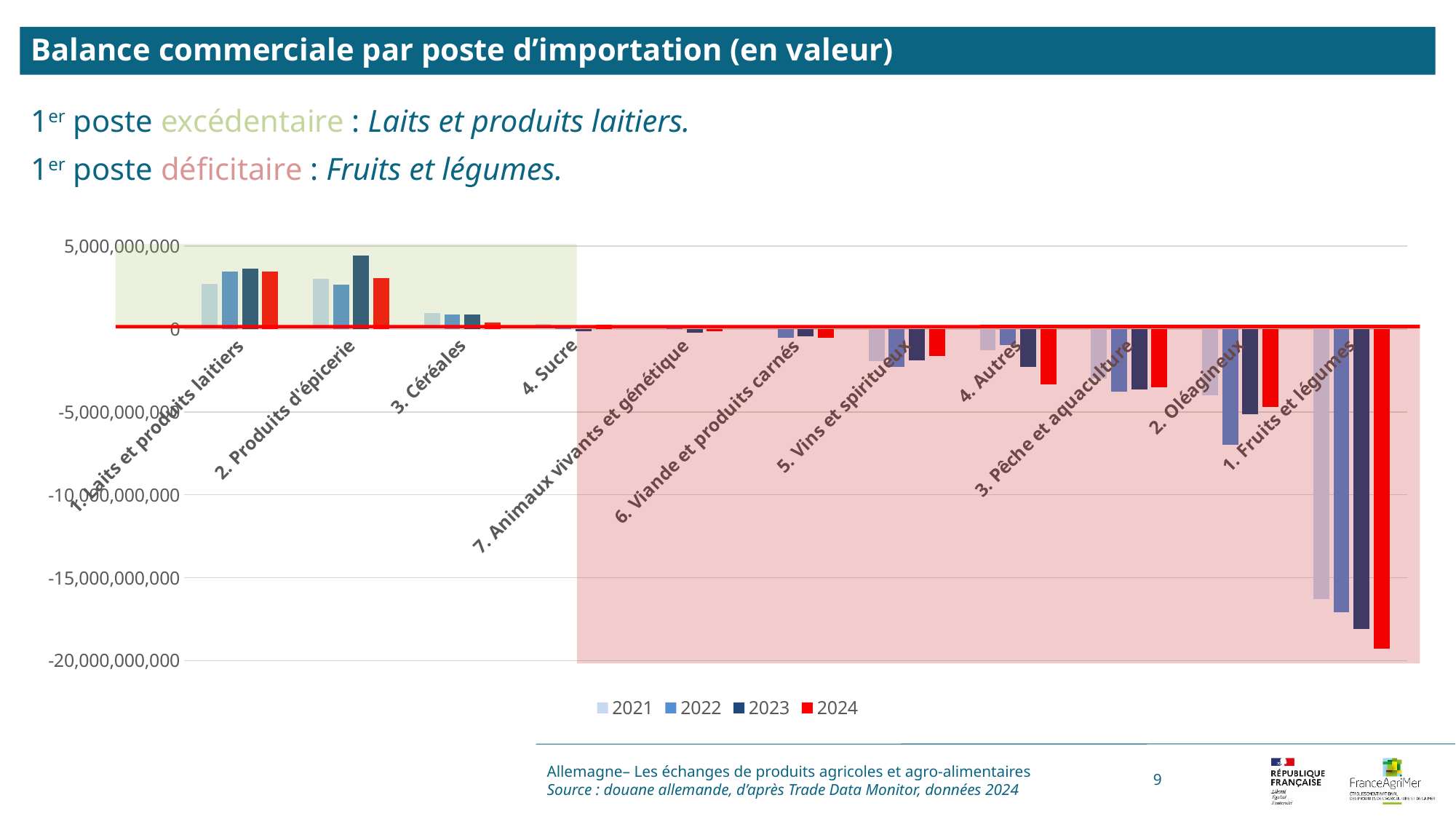
Which colour represents the 2024 series in the legend? Red Is the 2024 value for 1. Fruits et légumes greater or less than -15,000,000,000? less How many series does the legend list? 4 For 1. Fruits et légumes, which is larger, the 2021 value or the 2024 value? 2021 Which category has the lowest (most negative) value in 2024? 1. Fruits et légumes Is the 2024 value for 3. Pêche et aquaculture greater or less than -5,000,000,000? greater Which category has the highest value in 2023? 2. Produits d'épicerie What kind of chart is shown on the slide? Bar chart How many categories are plotted on the x axis? 11 Is the 2023 value for 2. Produits d'épicerie greater or less than 5,000,000,000? less For 1. Fruits et légumes, do the values rise or fall from 2021 to 2024? fall